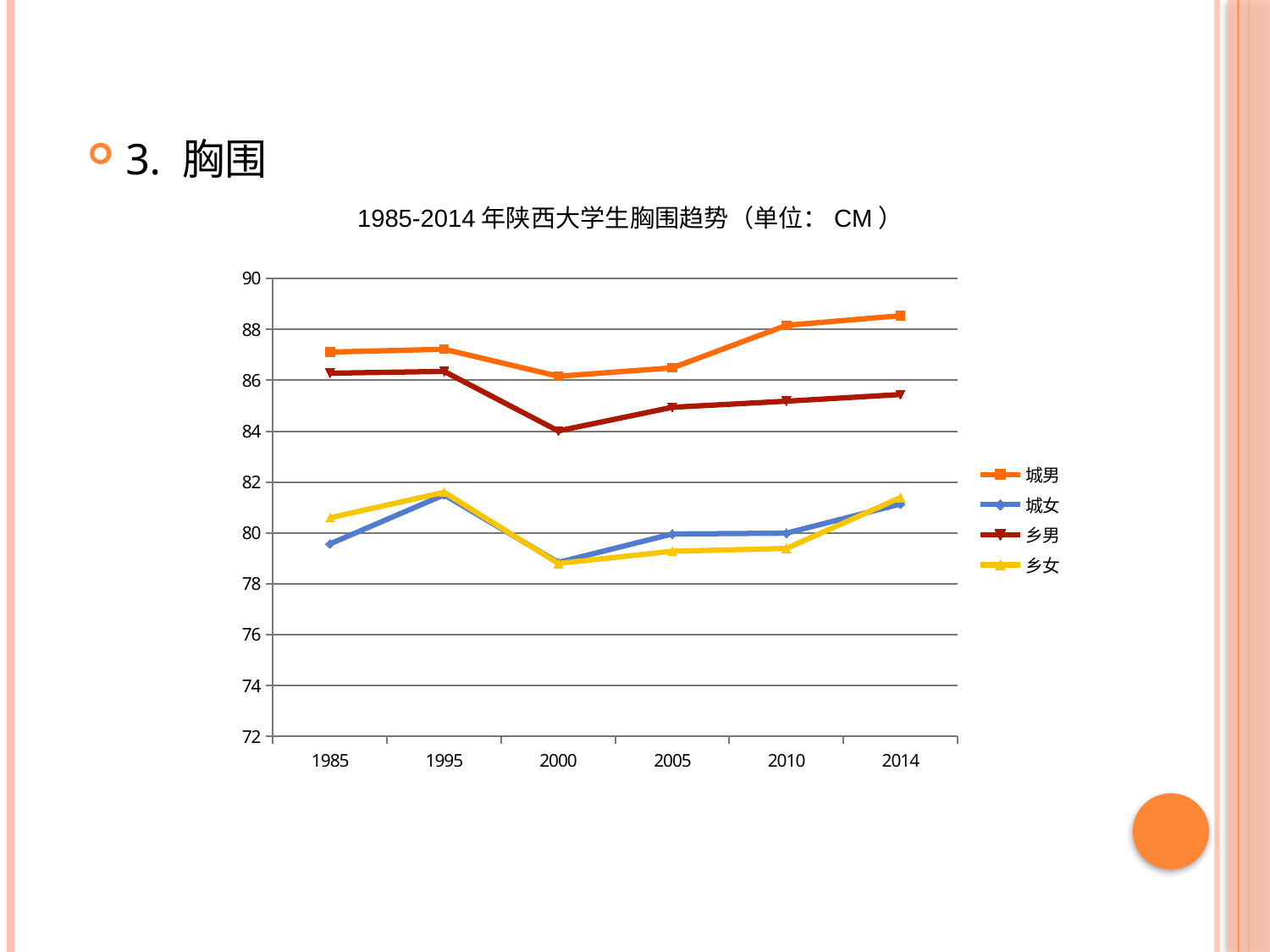
Is the value for 城女 in 1995 greater or less than 80? greater Which series has the lowest value in 1985? 城女 Is the value for 乡男 in 2000 greater or less than 86? less In which year is the value for 乡男 lowest? 2000 In 2005, which is larger, the value for 城男 or the value for 乡男? 城男 What kind of chart is shown on the slide? line chart Which series has the highest value in 2014? 城男 How many years are plotted along the x axis? 6 What is the title of the chart? 1985-2014年陕西大学生胸围趋势（单位：CM） Do the values for 城男 rise or fall from 2000 to 2014? rise How many series does the legend list? 4